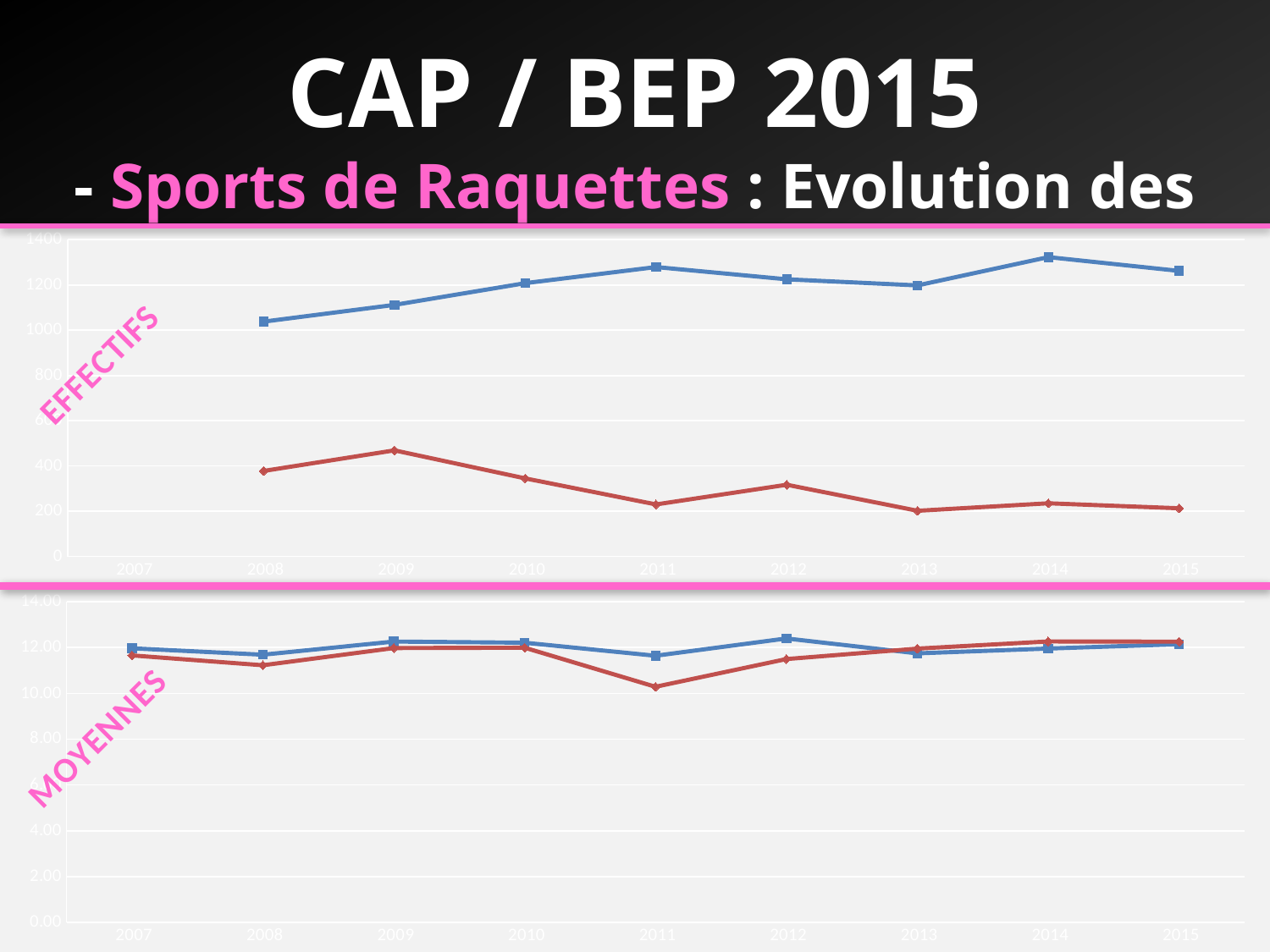
In the bottom chart (MOYENNES), is the value of the red series in 2011 greater or less than 12.00? less How many years are shown on the x axis of the bottom chart (MOYENNES)? 9 In the top chart (EFFECTIFS), which series is higher in 2012, the blue one or the red one? the blue one What is the pink label written beside the top chart? EFFECTIFS In the top chart (EFFECTIFS), is the value of the blue series in 2008 greater or less than 1000? greater In the top chart (EFFECTIFS), in which year does the blue series reach its highest value? 2014 In the bottom chart (MOYENNES), in which year does the red series reach its lowest value? 2011 In the top chart (EFFECTIFS), in which year does the red series reach its highest value? 2009 In the top chart (EFFECTIFS), is the value of the red series in 2011 greater or less than 400? less What kind of chart is the top chart labelled EFFECTIFS? line chart In the top chart (EFFECTIFS), does the blue series rise or fall from 2008 to 2011? rise